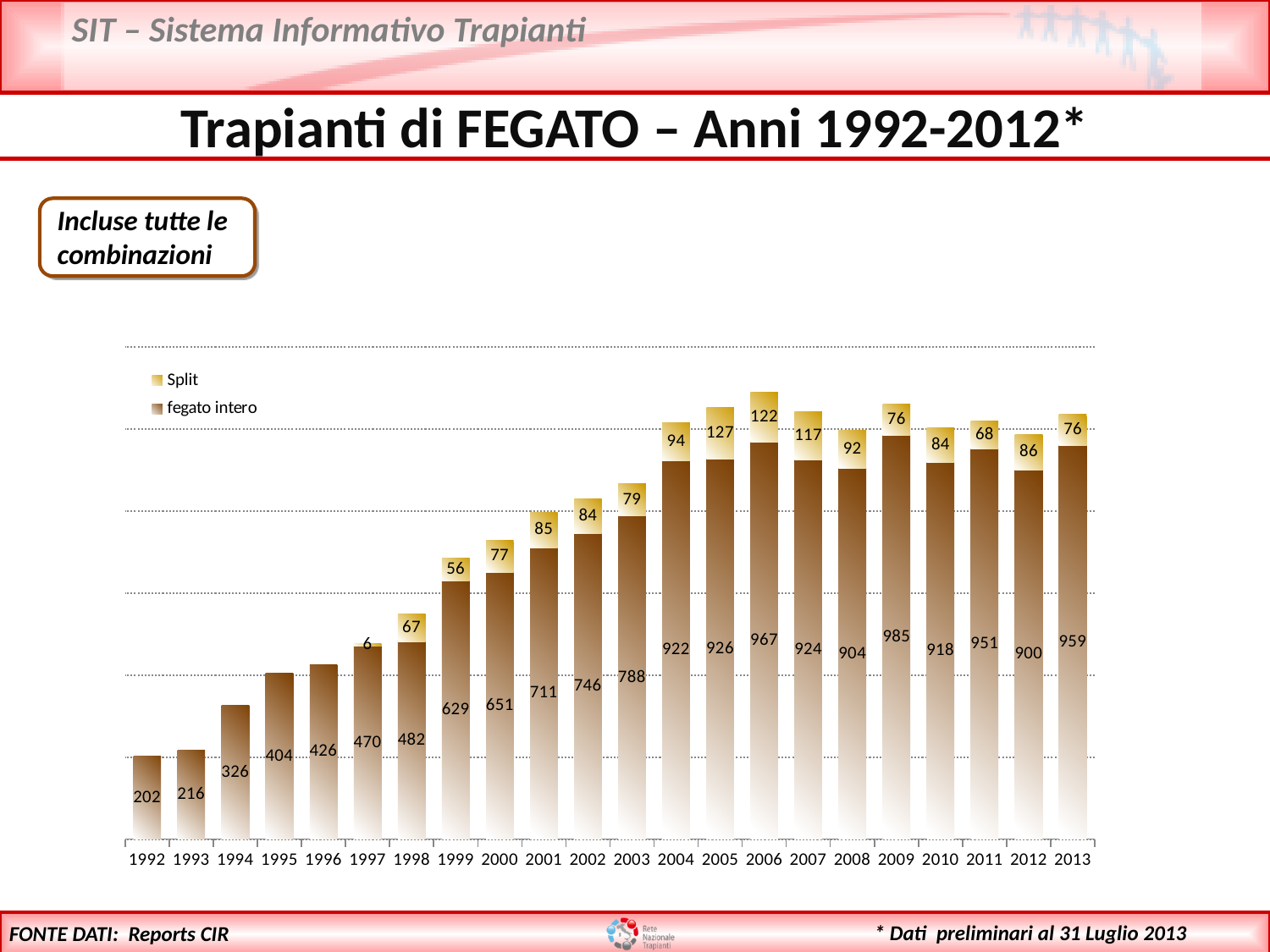
Which year has the highest fegato intero value? 2009 What kind of chart is shown on the slide? Stacked bar chart What are the two series named in the legend? Split and fegato intero What is the total height of the stacked bar for 2006 (fegato intero plus Split)? 1089 How many series does the legend list? 2 What is the difference between the fegato intero values for 2013 and 2012? 59 What is the value of fegato intero for 1992? 202 Do the fegato intero values generally rise or fall from 1992 to 2004? Rise What is the Split value for 2005? 127 Which is larger, the fegato intero value for 2006 or for 2007? 2006 How many years are shown on the x axis? 22 Which year has the lowest fegato intero value? 1992